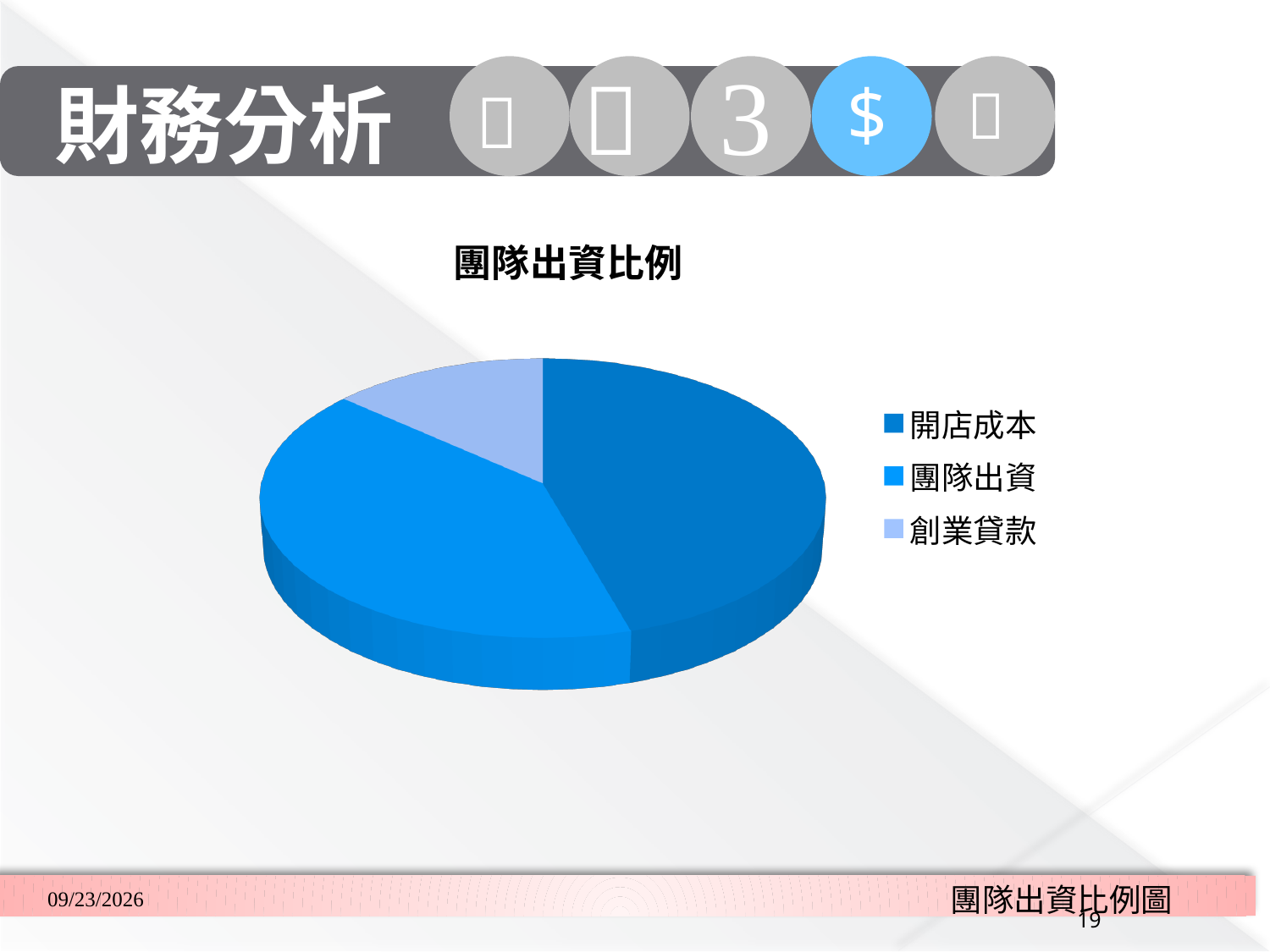
Which category has the smallest slice in the pie chart? 創業貸款 How many slices does the pie chart have? 3 What is the title of the pie chart? 團隊出資比例 How many entries does the legend of the pie chart list? 3 Which slice is larger in the pie chart, 開店成本 or 創業貸款? 開店成本 Which category is shown in the lightest blue colour in the pie chart? 創業貸款 What kind of chart is shown on the slide? pie chart Which slice is larger in the pie chart, 團隊出資 or 創業貸款? 團隊出資